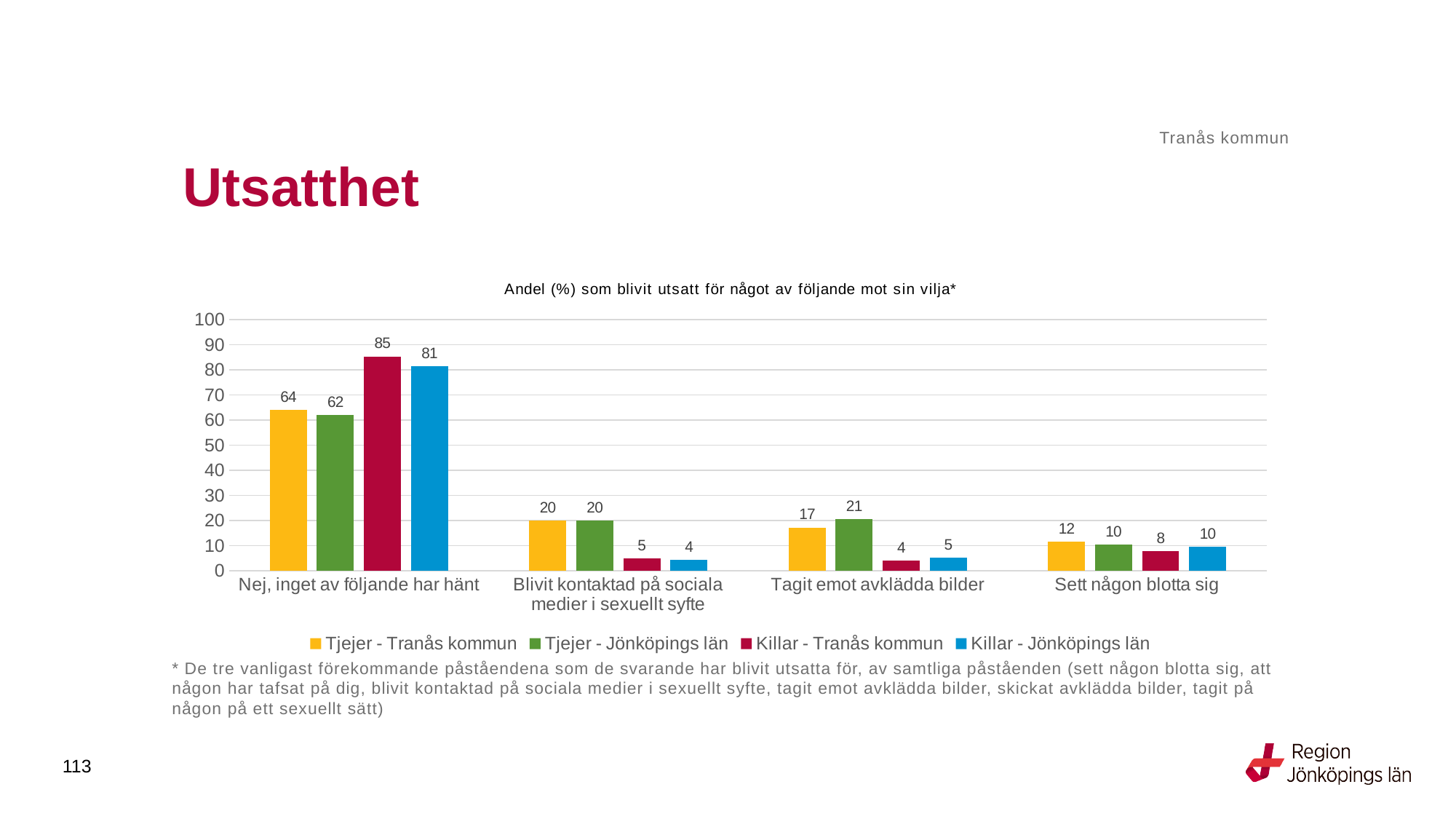
What is the value for Tjejer - Jönköpings län in the category 'Tagit emot avklädda bilder'? 21 How many series does the legend list? 4 Which series has the lowest value in the category 'Blivit kontaktad på sociala medier i sexuellt syfte'? Killar - Jönköpings län What is the title of the chart? Andel (%) som blivit utsatt för något av följande mot sin vilja* Which is larger in the category 'Sett någon blotta sig': Tjejer - Tranås kommun or Killar - Tranås kommun? Tjejer - Tranås kommun What kind of chart is shown on the slide? Bar chart Is the value for Killar - Jönköpings län in 'Nej, inget av följande har hänt' greater or less than 70? greater What is the difference between Tjejer - Tranås kommun and Killar - Tranås kommun in the category 'Tagit emot avklädda bilder'? 13 What is the value for Killar - Tranås kommun in the category 'Nej, inget av följande har hänt'? 85 Which series has the highest value in the category 'Nej, inget av följande har hänt'? Killar - Tranås kommun What is the value for Killar - Jönköpings län in the category 'Sett någon blotta sig'? 10 How many categories are shown on the x axis? 4